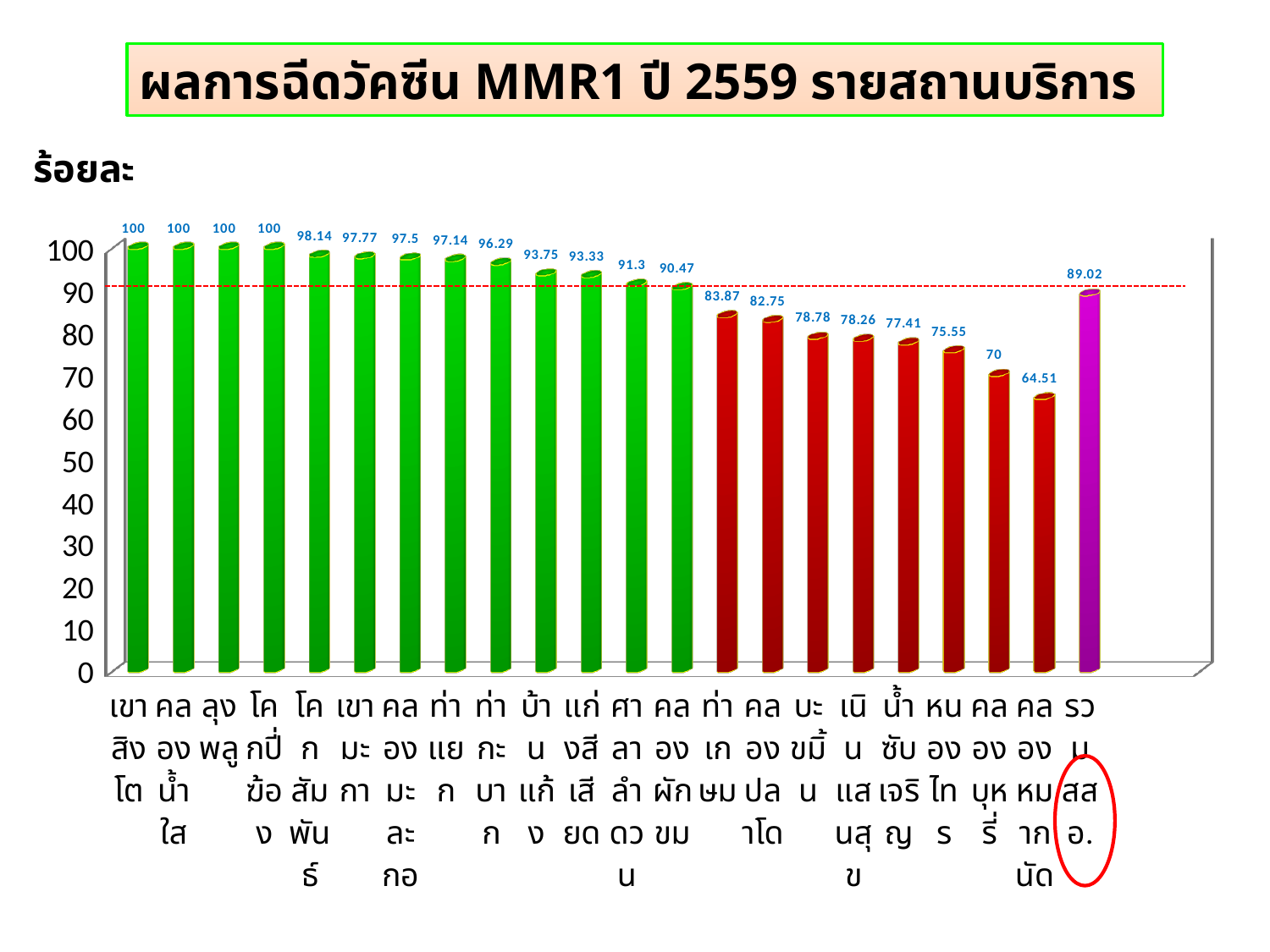
What is the value for รวม สสอ. (the purple bar)? 89.02 Do the values of the facility bars generally rise or fall from left to right (excluding the final รวม สสอ. bar)? fall What is the value for คลองหมากนัด? 64.51 Which category has the lowest value? คลองหมากนัด What is the difference between the values for คลองบุหรี่ and คลองหมากนัด? 5.49 What is the value for โคกสัมพันธ์? 98.14 Is the value for น้ำซับเจริญ greater or less than 80? less How many bars are shown in the chart? 22 What is the value for ท่าเกษม? 83.87 Which is larger, the value for บะขมิ้น or the value for หนองไทร? บะขมิ้น What kind of chart is shown on the slide? bar chart What is the title of the chart? ผลการฉีดวัคซีน MMR1 ปี 2559 รายสถานบริการ